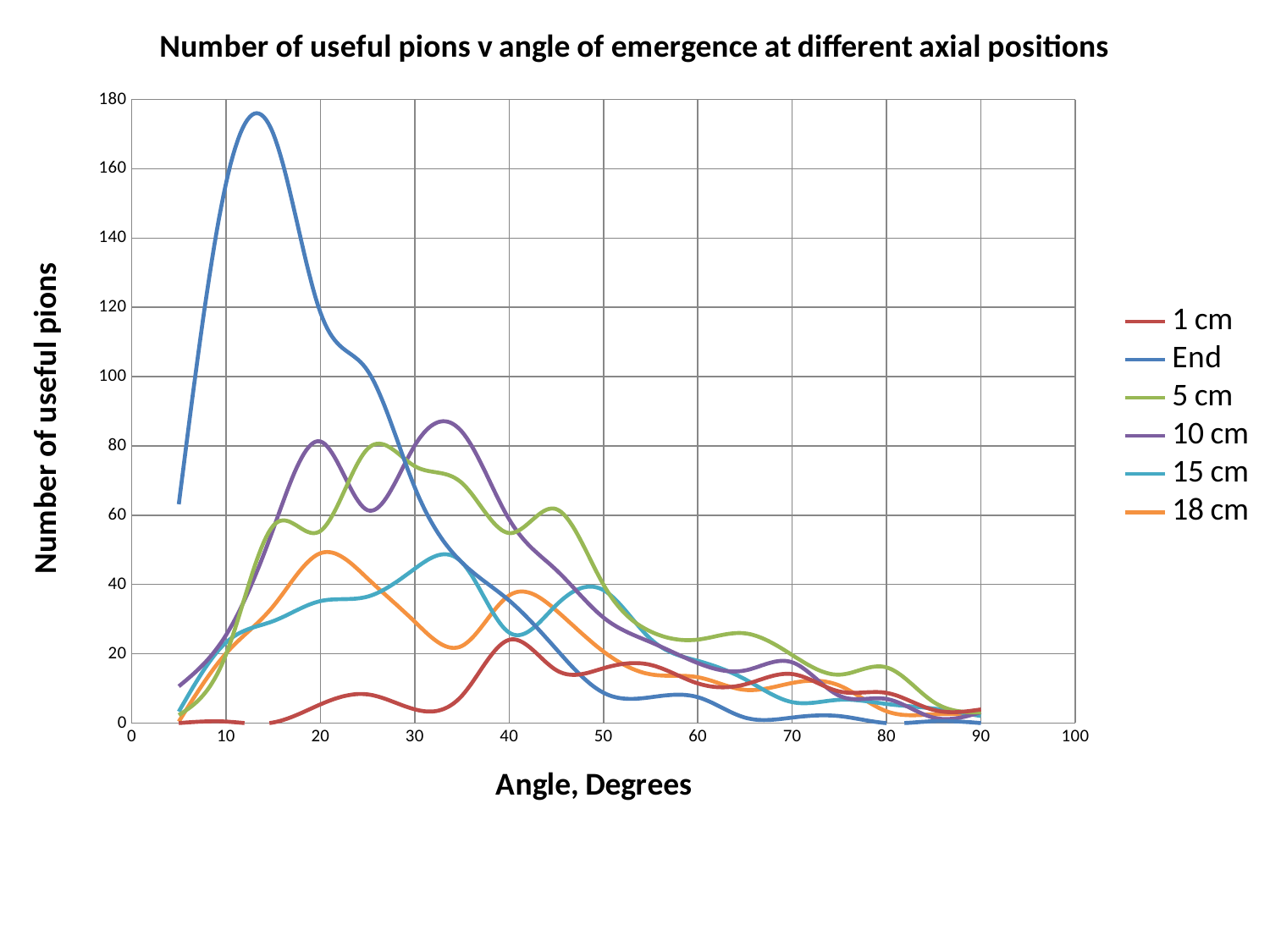
Is the peak value of the 10 cm series greater or less than 80? greater At an angle of 20 degrees, which series has the larger value, 10 cm or 18 cm? 10 cm Is the peak value of the End series greater or less than 160? greater What is the title of the chart? Number of useful pions v angle of emergence at different axial positions Does the End series rise or fall as the angle increases from 20 to 60 degrees? fall Is the peak value of the 5 cm series greater or less than 100? less How many series does the legend list? 6 Which series has the lowest peak number of useful pions? 1 cm What kind of chart is shown on the slide? line chart Which series reaches the highest number of useful pions? End